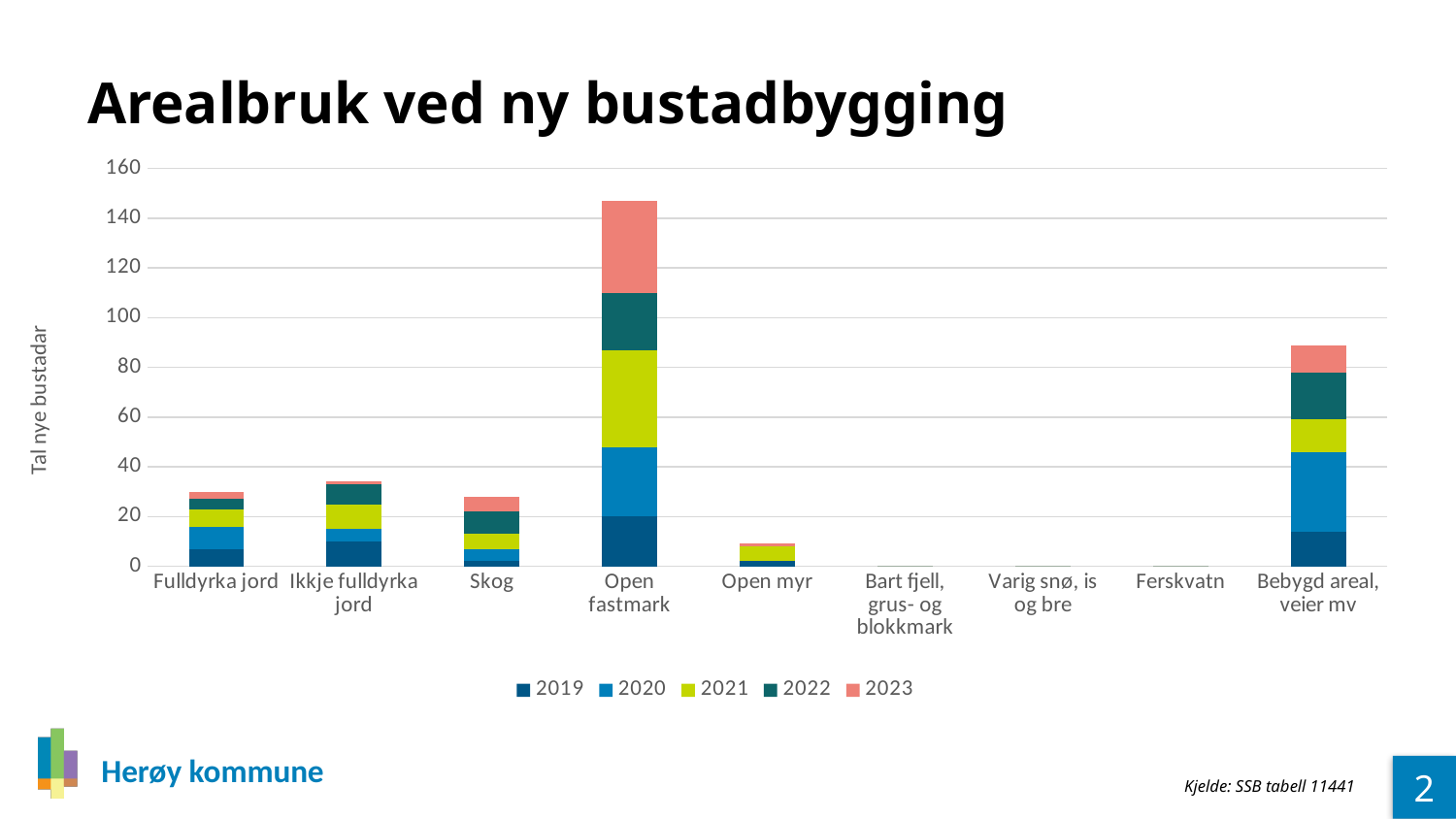
What is the title of the chart? Arealbruk ved ny bustadbygging Is the total value for Bebygd areal, veier mv greater or less than 100? less Is the total value for Open fastmark greater or less than 140? greater How many series does the legend list? 5 Which category has the highest total stacked bar? Open fastmark How many categories are shown on the x axis of the chart? 9 What is the label on the y axis of the chart? Tal nye bustadar What kind of chart is shown on the slide? Stacked bar chart Is the total value for Skog greater or less than 20? greater Which has the larger total bar, Skog or Open myr? Skog Which has the larger total bar, Open fastmark or Bebygd areal, veier mv? Open fastmark